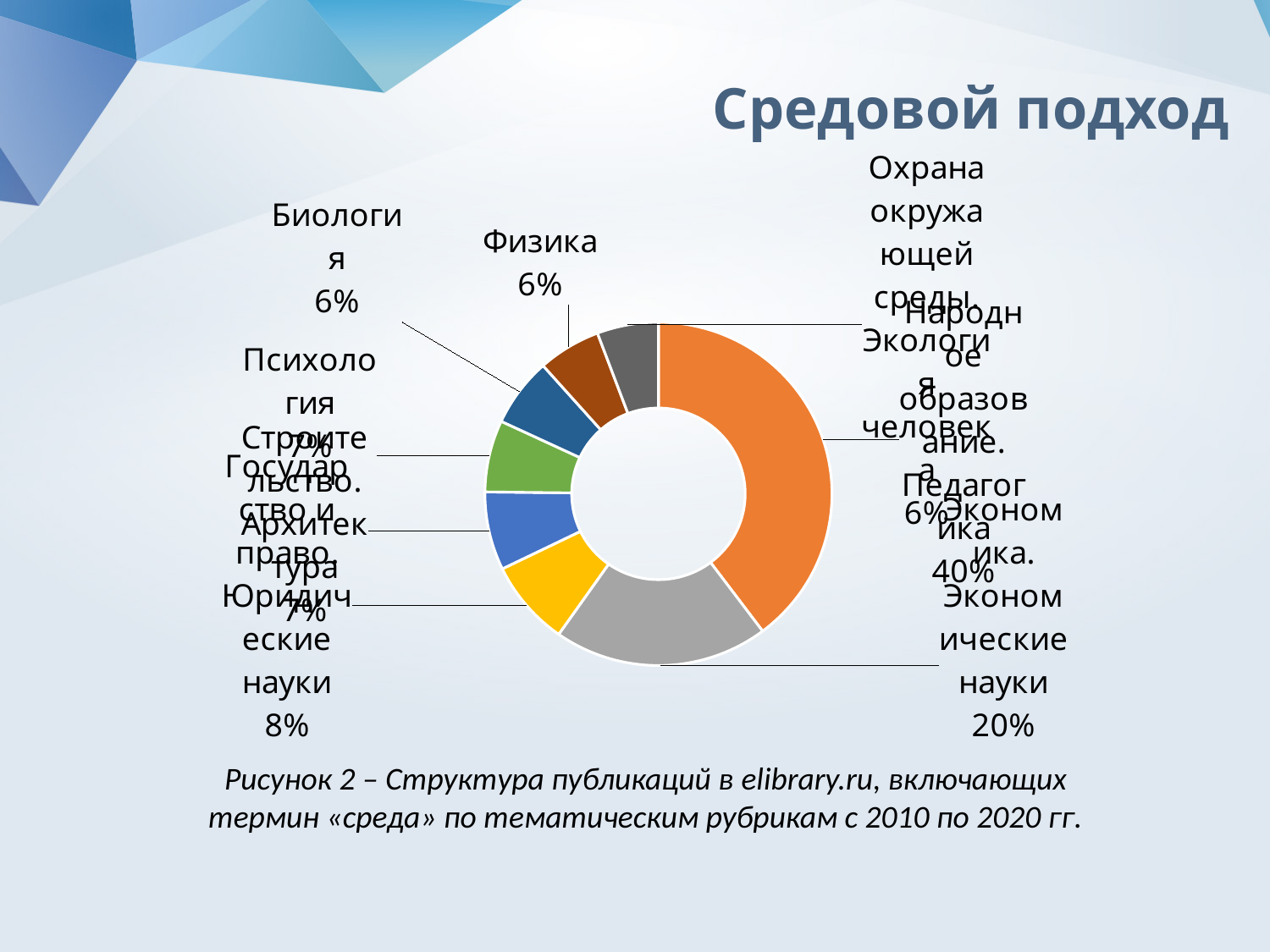
What colour is the largest slice of the chart? Orange What kind of chart is shown on the slide? Doughnut (pie) chart What share of publications is shown for Физика? 6% What is the difference between the shares for Экономические науки and Биология? 14% What share of publications is shown for Биология? 6% What is the figure number given in the caption below the chart? Рисунок 2 How many slices does the doughnut chart have? 8 What share of publications is shown for Юридические науки? 8% What share of publications is shown for Экономические науки? 20% Which is larger, the share for Экономические науки or the share for Физика? Экономические науки What percentage is shown for the largest slice of the chart? 40%